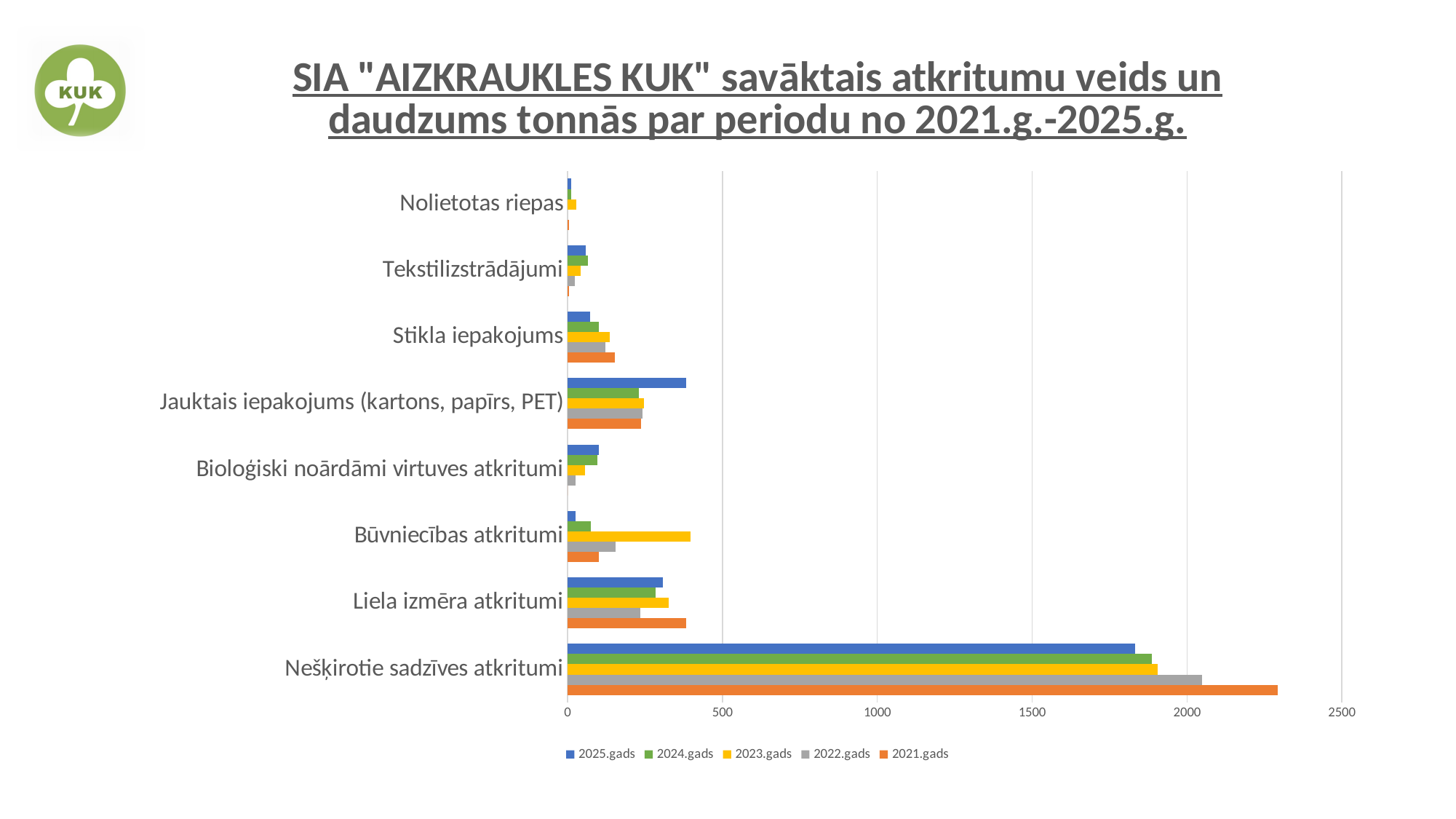
Is the 2023.gads value for Būvniecības atkritumi greater or less than 500? less Which waste category has the lowest values in the chart? Nolietotas riepas Which series is listed first in the chart legend? 2025.gads Is the 2025.gads value for Nešķirotie sadzīves atkritumi greater or less than 2000? less How many series does the chart legend list? 5 For Nešķirotie sadzīves atkritumi, which year has the highest value? 2021.gads What kind of chart is shown on the slide? bar chart For Būvniecības atkritumi, which is larger: the 2023.gads value or the 2025.gads value? 2023.gads Is the 2021.gads value for Nešķirotie sadzīves atkritumi greater or less than 2000? greater For Jauktais iepakojums (kartons, papīrs, PET), which is larger: the 2025.gads value or the 2024.gads value? 2025.gads How many waste categories are listed on the vertical axis of the chart? 8 Which waste category has the highest values in the chart? Nešķirotie sadzīves atkritumi